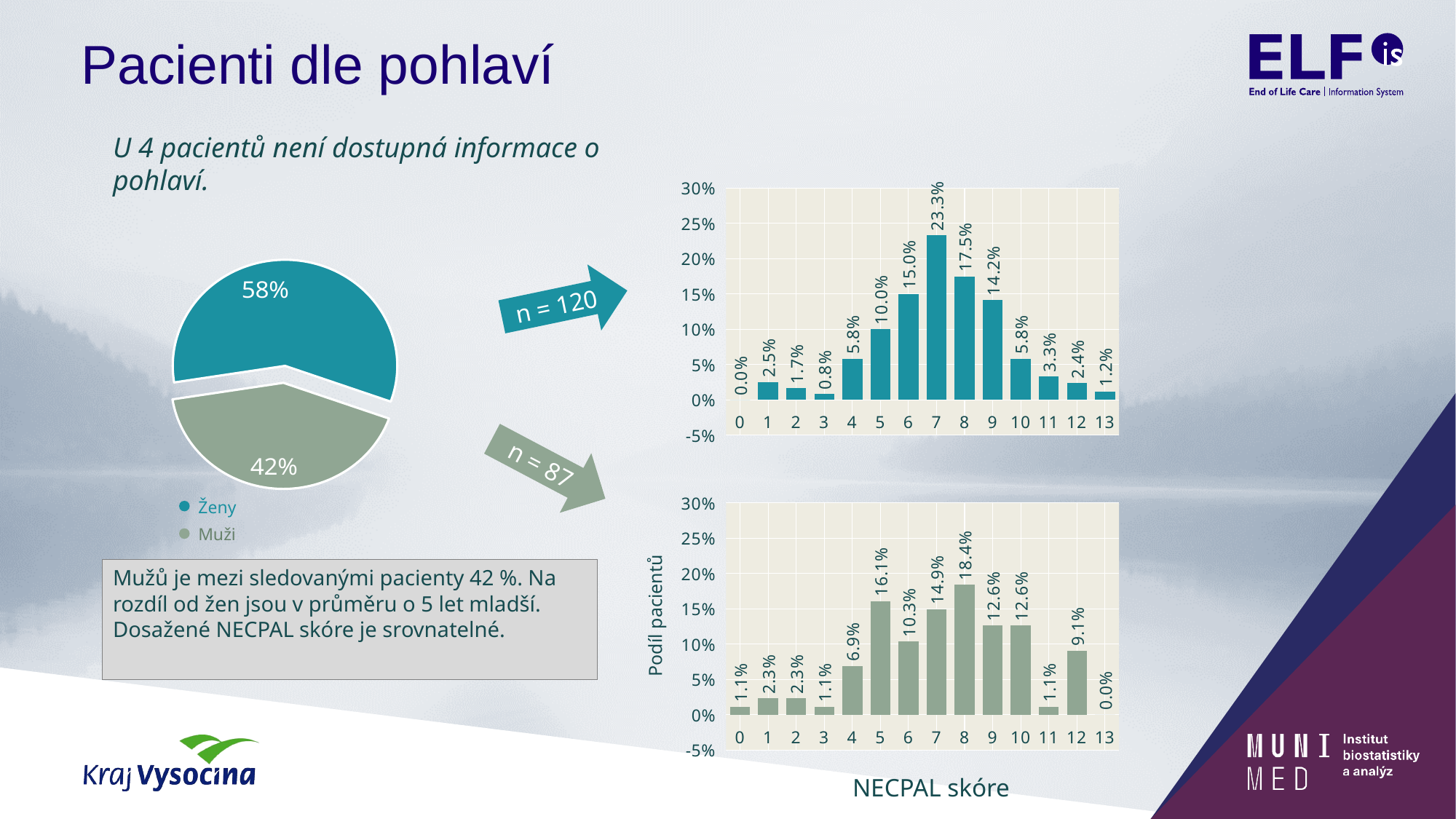
In the pie chart on the left, what share of patients are Ženy? 58% In the bottom bar chart on the right, which is larger: the value for NECPAL score 5 or NECPAL score 6? NECPAL score 5 In the bottom bar chart on the right, what is the value for NECPAL score 8? 18.4% In the top bar chart on the right, what is the difference between the values for NECPAL score 7 and NECPAL score 8? 5.8% How many entries does the legend of the pie chart on the left list? 2 In the bottom bar chart on the right, what is the value for NECPAL score 12? 9.1% In the top bar chart on the right, which NECPAL score has the highest value? 7 In the top bar chart on the right, how many NECPAL score categories are shown on the x axis? 14 In the bottom bar chart on the right, which NECPAL score has the highest value? 8 In the top bar chart on the right, what is the value for NECPAL score 7? 23.3% In the pie chart on the left, what share of patients are Muži? 42% What kind of chart is the bottom chart on the right? Bar chart